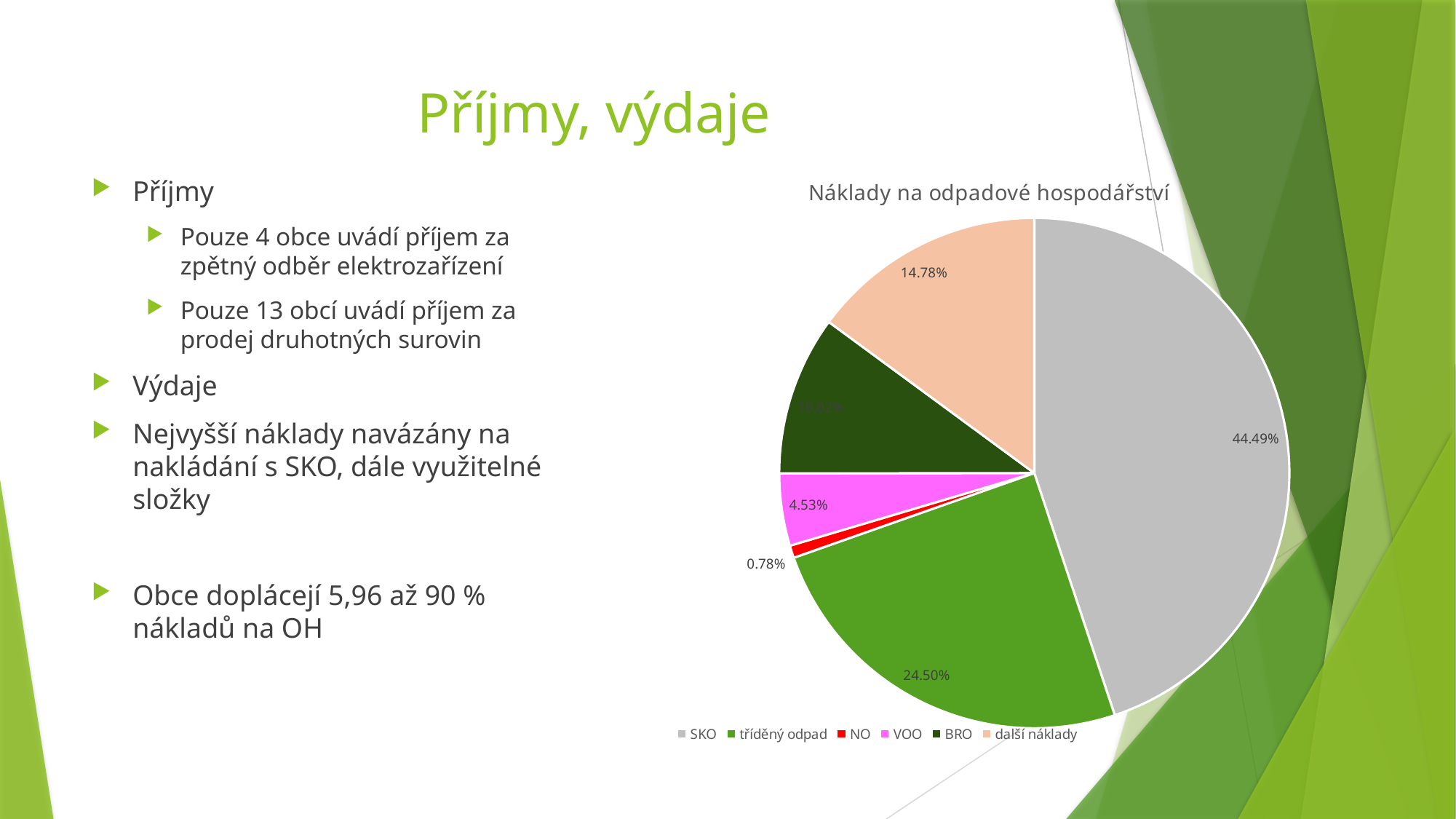
What percentage is shown for tříděný odpad? 24.50% Which category has the smallest slice of the pie? NO What is the difference between the SKO share and the tříděný odpad share? 19.99% How many categories does the pie chart contain? 6 What share of the pie does SKO account for? 44.49% What is the title of the chart? Náklady na odpadové hospodářství Which category has the largest slice of the pie? SKO What type of chart is shown on the slide? Pie chart What percentage does the VOO slice show? 4.53% Which slice is larger, VOO or NO? VOO What is the value of the NO slice? 0.78% What share is labelled for další náklady? 14.78%